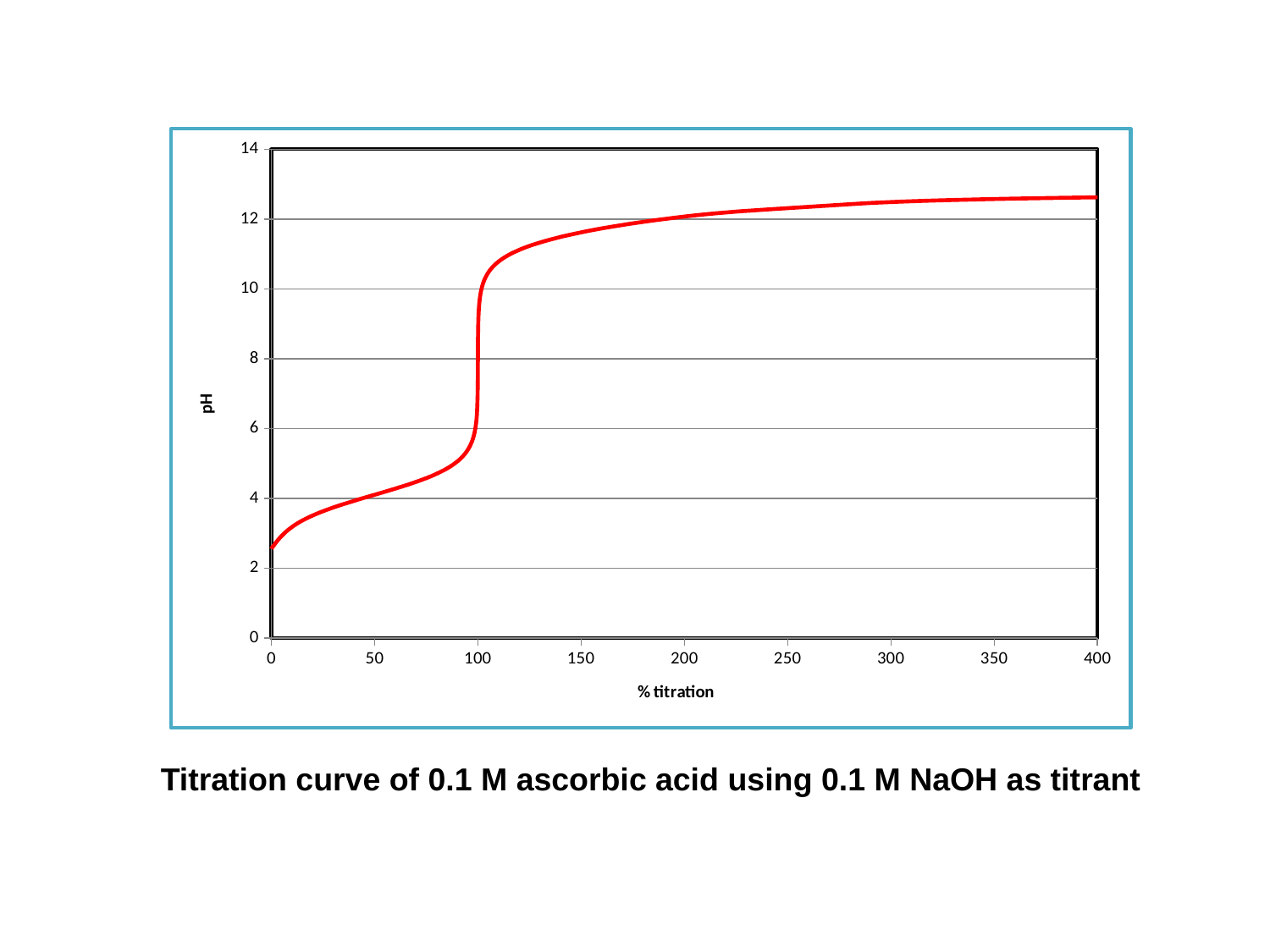
Is the pH at 200% titration greater or less than 10? greater Is the pH at 150% titration greater or less than 8? greater What is the label of the x axis? % titration Which has the higher pH: 50% titration or 150% titration? 150% titration Does the pH rise or fall as % titration increases from 0 to 400? rise Is the pH at 0% titration greater or less than 4? less What is the label of the y axis? pH What kind of chart is shown on the slide? line chart